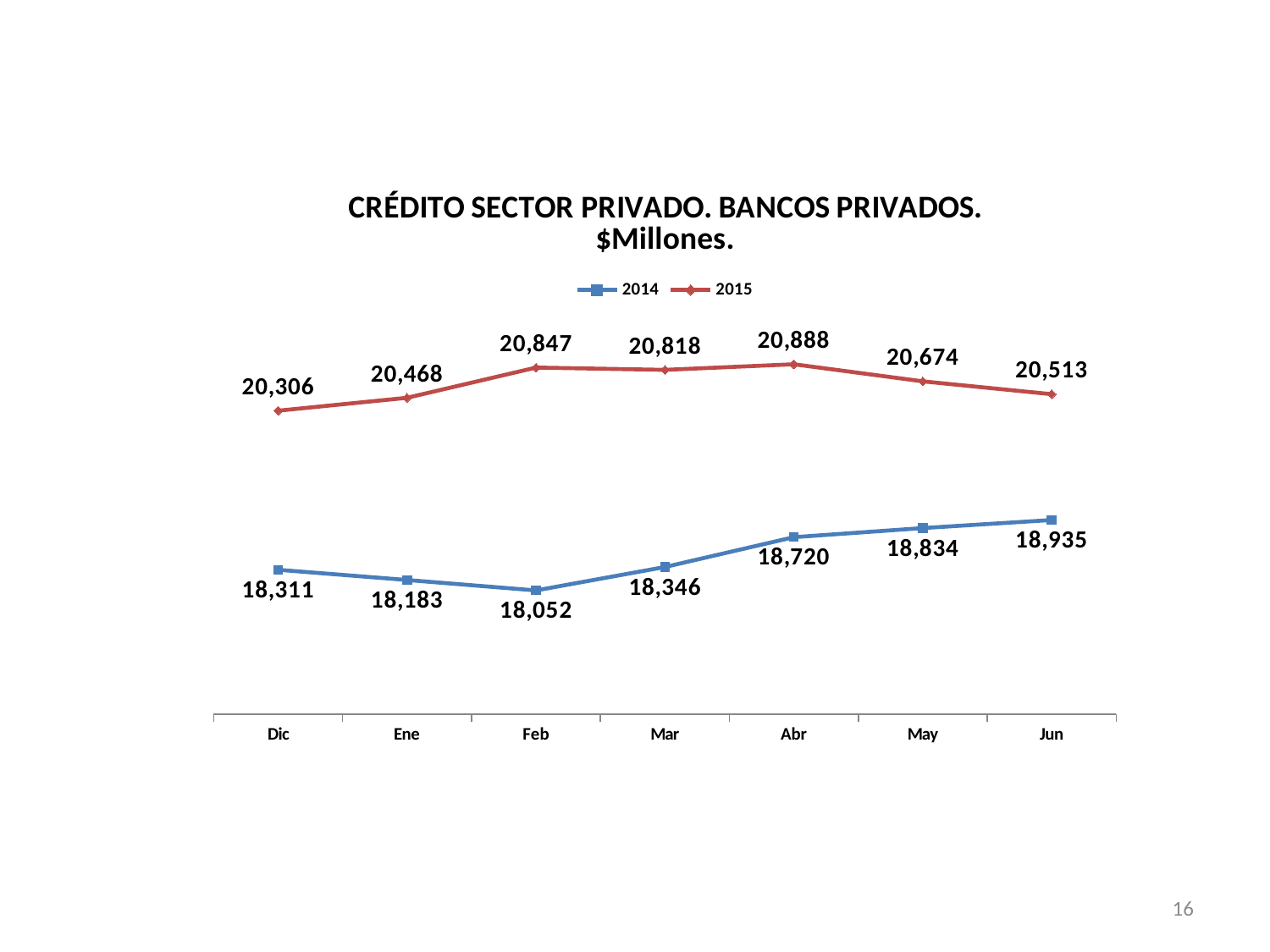
How many series does the legend list? 2 In which month does the 2014 series have its lowest value? Feb Does the 2015 series rise or fall from Abr to Jun? Fall How much higher is the 2014 value in Jun than in Dic? 624 Which is larger, the 2015 value in Feb or the 2015 value in Mar? Feb (20,847) What kind of chart is this? Line chart What is the value for 2015 in Abr? 20,888 What is the value for 2014 in Feb? 18,052 What is the value for 2014 in Jun? 18,935 How many months are shown on the x axis? 7 In which month does the 2015 series reach its highest value? Abr What is the difference between the 2015 and 2014 values in Abr? 2,168